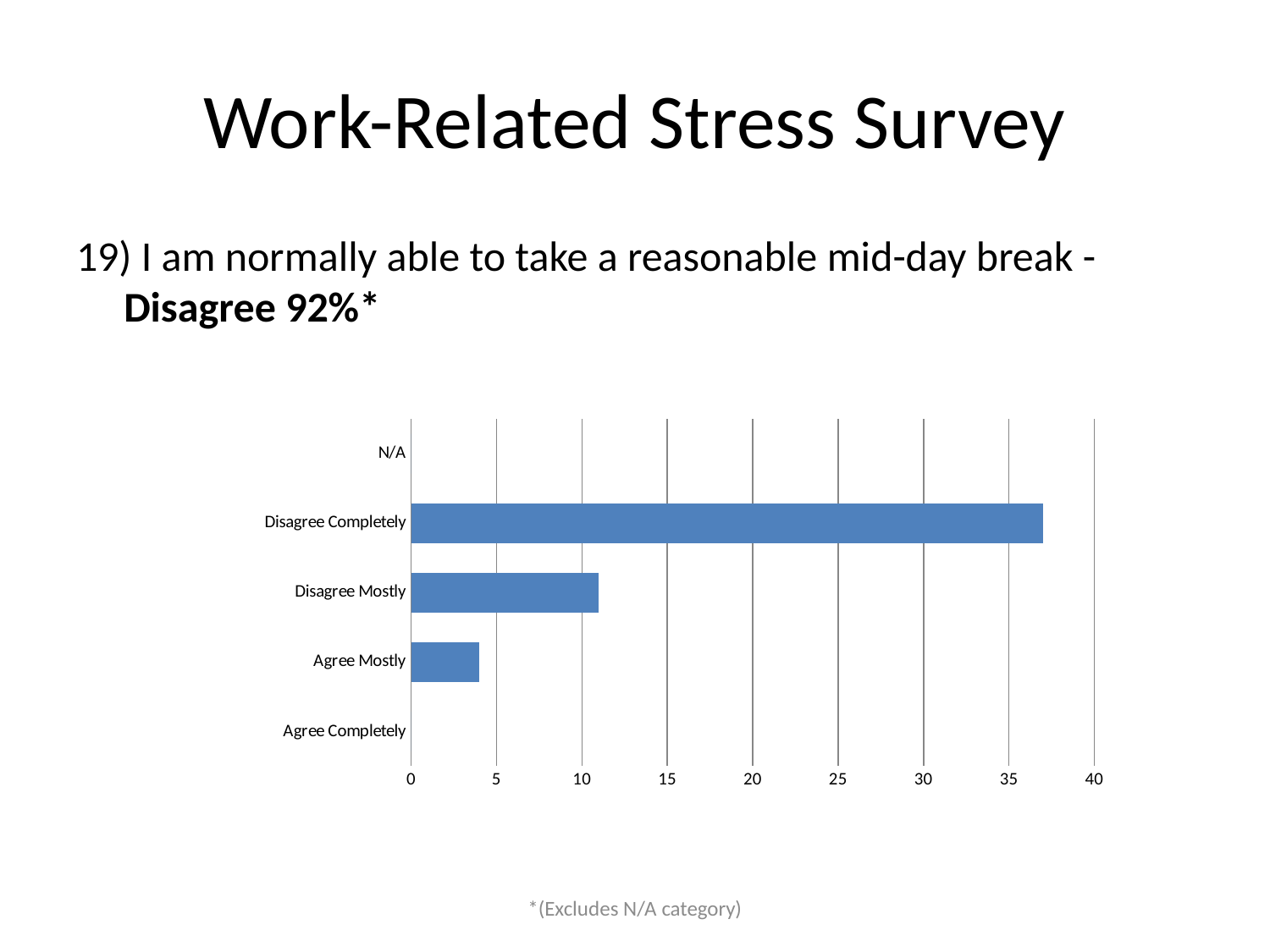
Which is larger, the value for Disagree Completely or the value for Disagree Mostly? Disagree Completely Is the value for Agree Mostly greater or less than 5? less What is the title of the slide containing the chart? Work-Related Stress Survey Is the value for Disagree Mostly greater or less than 10? greater What is the highest value shown on the chart's horizontal axis? 40 Which is larger, the value for Disagree Mostly or the value for Agree Mostly? Disagree Mostly How many categories are shown on the chart's vertical axis? 5 Is the value for Disagree Completely greater or less than 35? greater What kind of chart is shown on the slide? bar chart Which category has the highest value in the chart? Disagree Completely